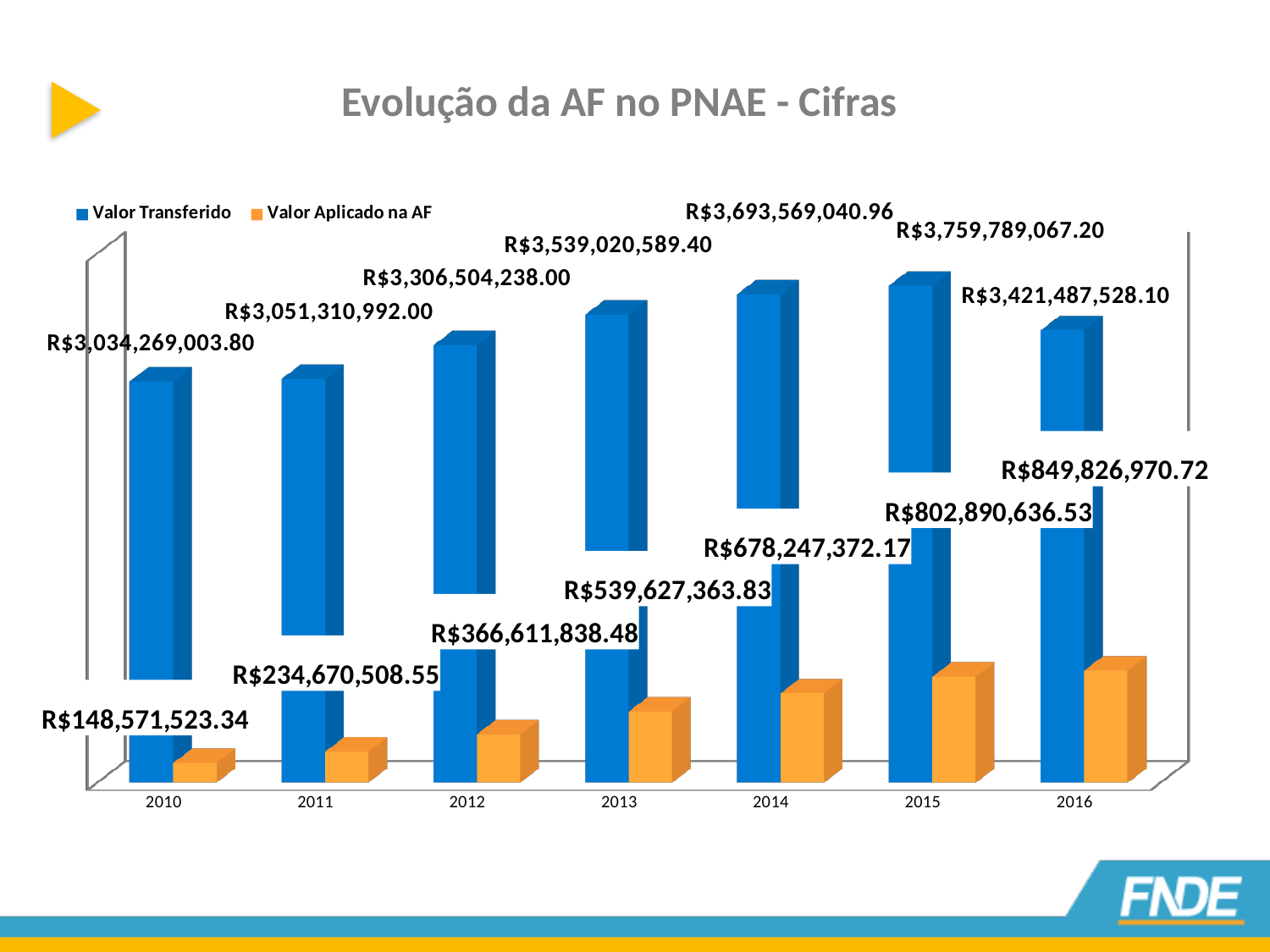
By how much did the Valor Aplicado na AF increase from 2010 to 2011? R$86,098,985.21 Which year has the lowest Valor Aplicado na AF? 2010 What is the difference between the Valor Transferido and the Valor Aplicado na AF in 2016? R$2,571,660,557.38 Which is larger, the Valor Transferido in 2012 or in 2016? 2016 Does the Valor Aplicado na AF rise or fall from 2010 to 2016? Rise What is the Valor Aplicado na AF for 2010? R$148,571,523.34 What is the Valor Aplicado na AF for 2014? R$678,247,372.17 How many series does the legend list? 2 How many years are shown on the x axis? 7 Which year has the highest Valor Transferido? 2015 What kind of chart is shown on the slide? Bar chart What is the Valor Transferido for 2013? R$3,539,020,589.40